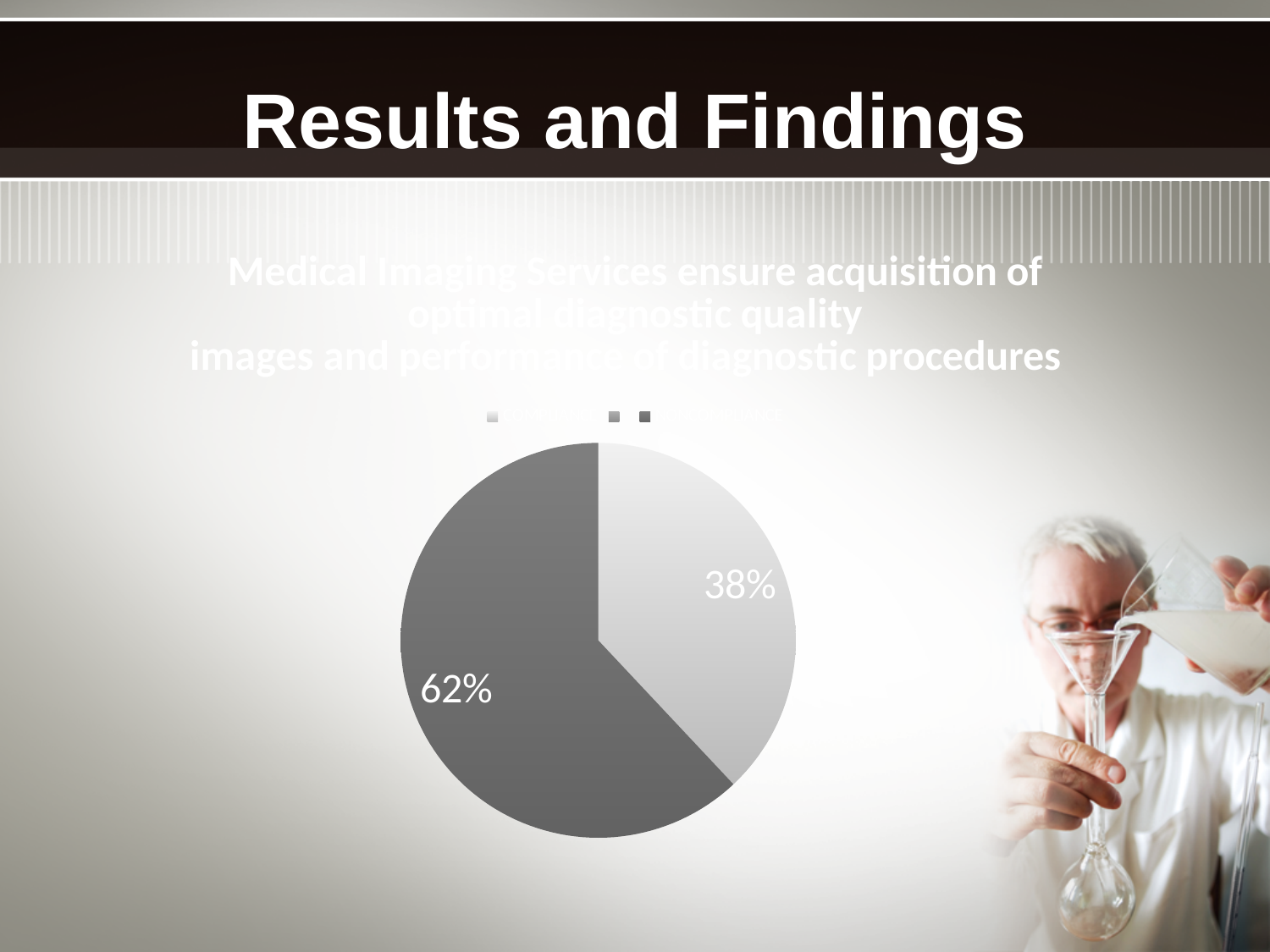
How many slices does the pie chart have? 2 What kind of chart is shown on the slide? pie chart What is the title of the slide? Results and Findings Which slice of the pie chart is the largest? the dark gray slice (62%) What percentage is shown on the dark gray slice of the pie chart? 62% What share of the pie does the light gray slice represent? 38% Is the dark gray slice greater or less than half of the pie? greater Which slice of the pie chart is the smallest? the light gray slice (38%) Which slice is larger, the dark gray slice or the light gray slice? the dark gray slice What percentage is shown on the light gray slice of the pie chart? 38% What is the title of the pie chart? Medical Imaging Services ensure acquisition of optimal diagnostic quality images and performance of diagnostic procedures What is the difference in percentage points between the two slices of the pie chart? 24 percentage points